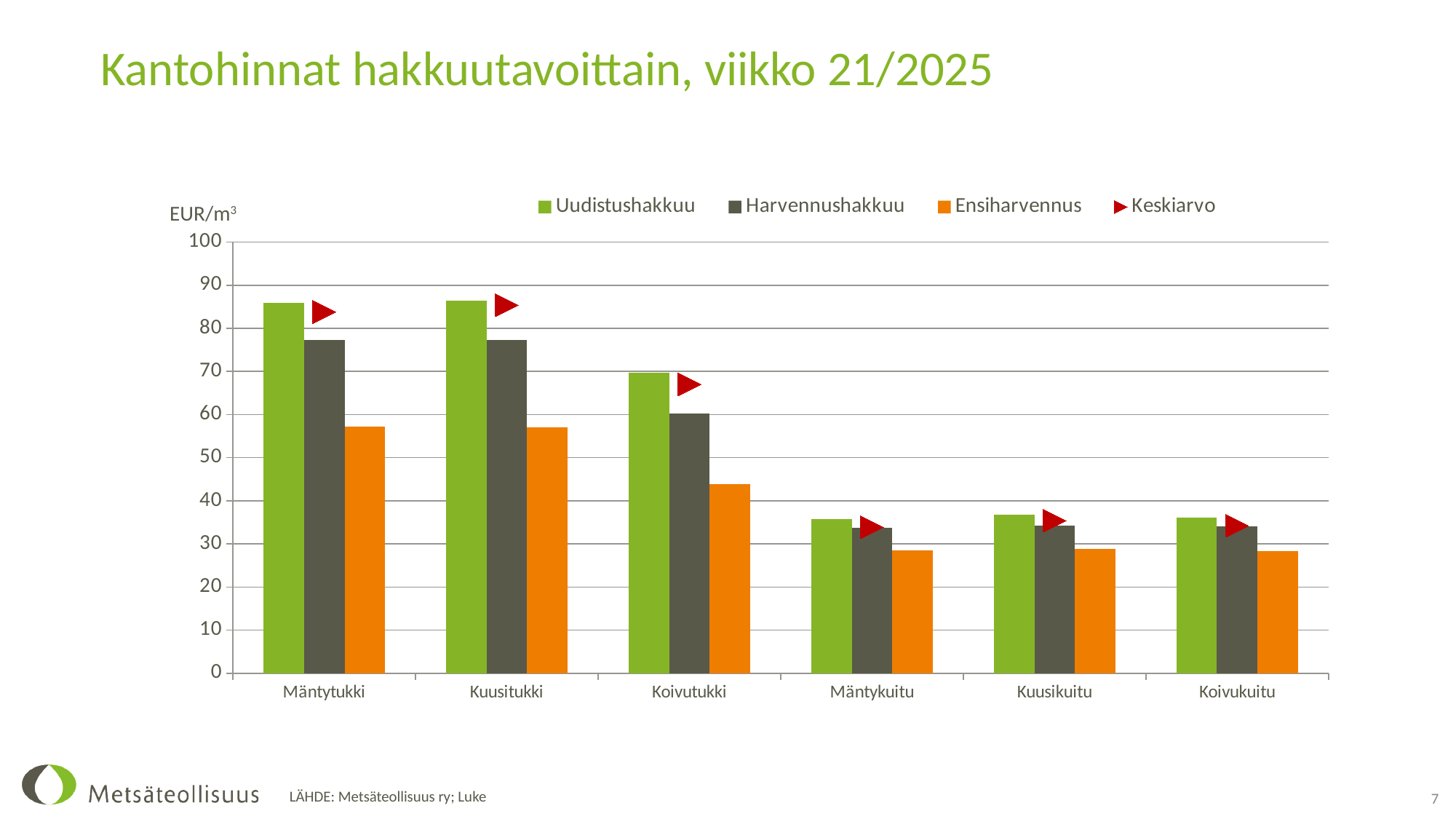
How many series does the legend list? 4 Which is larger: the Harvennushakkuu value for Mäntytukki or the Harvennushakkuu value for Koivutukki? Mäntytukki Is the Uudistushakkuu value for Mäntytukki greater or less than 80? greater Is the Ensiharvennus value for Mäntykuitu greater or less than 30? less How many categories are shown on the x axis? 6 What kind of chart is shown on the slide? bar chart Is the Uudistushakkuu value for Koivukuitu greater or less than 30? greater For Koivutukki, which is larger: the Uudistushakkuu value or the Ensiharvennus value? Uudistushakkuu What is the title of the chart? Kantohinnat hakkuutavoittain, viikko 21/2025 What unit is shown on the vertical axis? EUR/m³